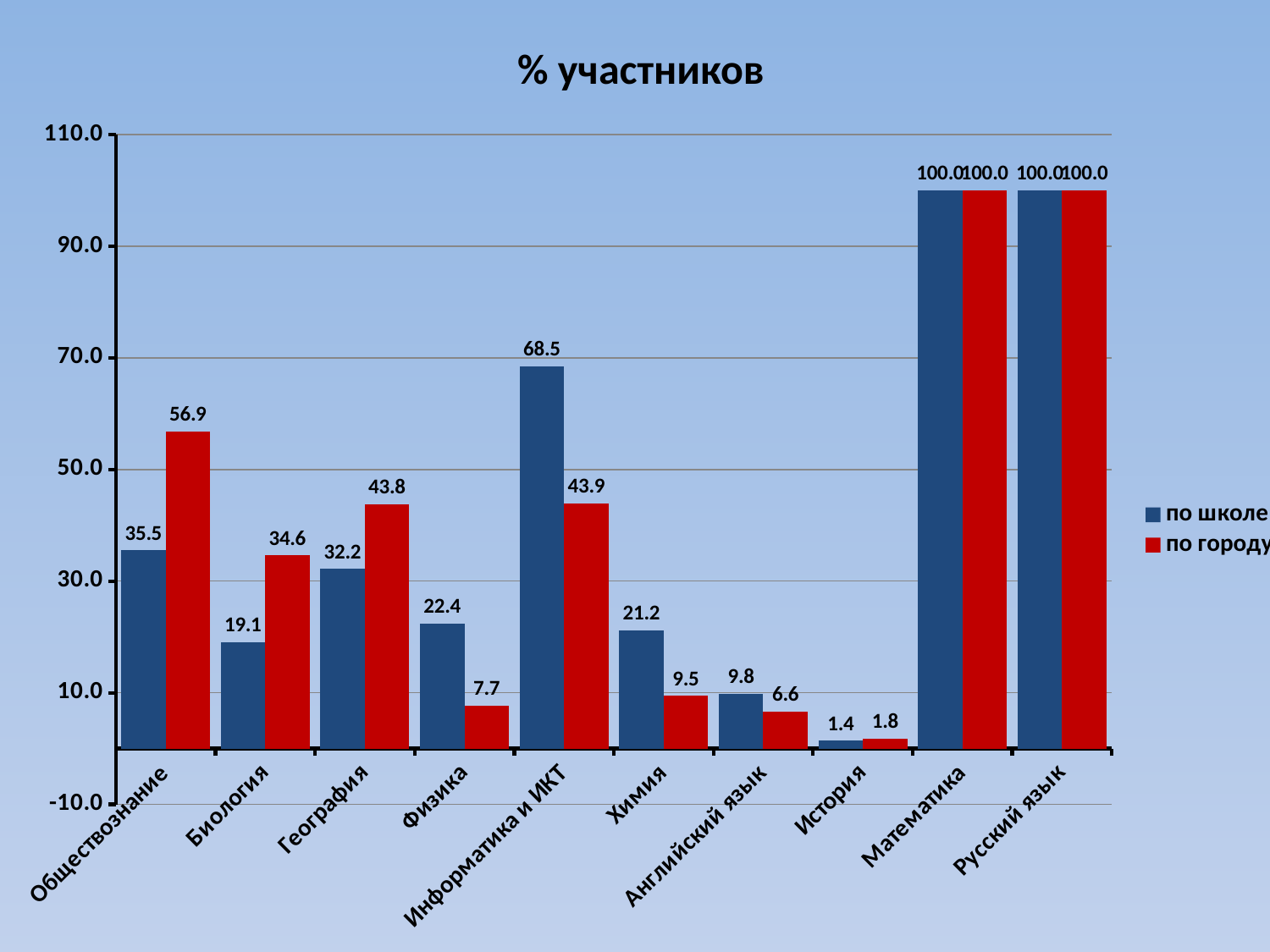
How many categories are shown on the x axis? 10 What is the value for "по городу" for Физика? 7.7 What is the value for "по городу" for Обществознание? 56.9 What is the value for "по школе" for Химия? 21.2 Which is larger for Биология: the "по школе" value or the "по городу" value? по городу What is the title of the chart? % участников How many series does the legend list? 2 What is the difference between the "по школе" and "по городу" values for Информатика и ИКТ? 24.6 Which category has the lowest "по школе" value? История What kind of chart is this? bar chart Excluding Математика and Русский язык, which category has the highest "по городу" value? Обществознание What is the value for "по школе" for Информатика и ИКТ? 68.5